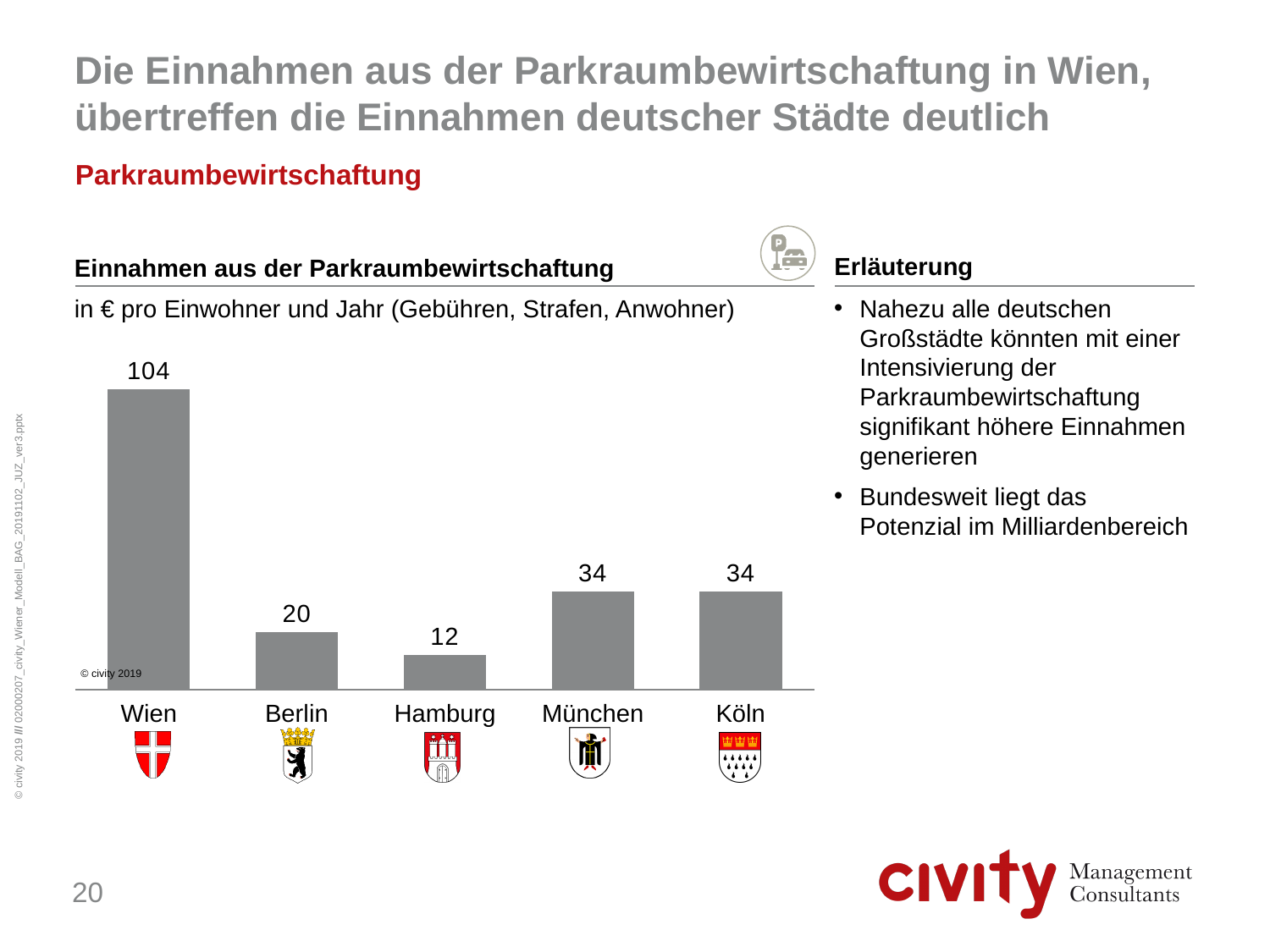
How many cities are shown in the chart? 5 What is the value for Hamburg in the chart? 12 Which city has the lowest value in the chart? Hamburg What is the value for Wien in the chart 'Einnahmen aus der Parkraumbewirtschaftung'? 104 What is the value for München in the chart? 34 What is the difference between the values for Berlin and Hamburg? 8 What is the value for Berlin in the chart? 20 What kind of chart is shown on the slide? Bar chart Which has a larger value, Berlin or München? München What is the difference between the values for Wien and Köln? 70 What unit is stated in the chart's subtitle? € pro Einwohner und Jahr Which city has the highest value in the chart? Wien